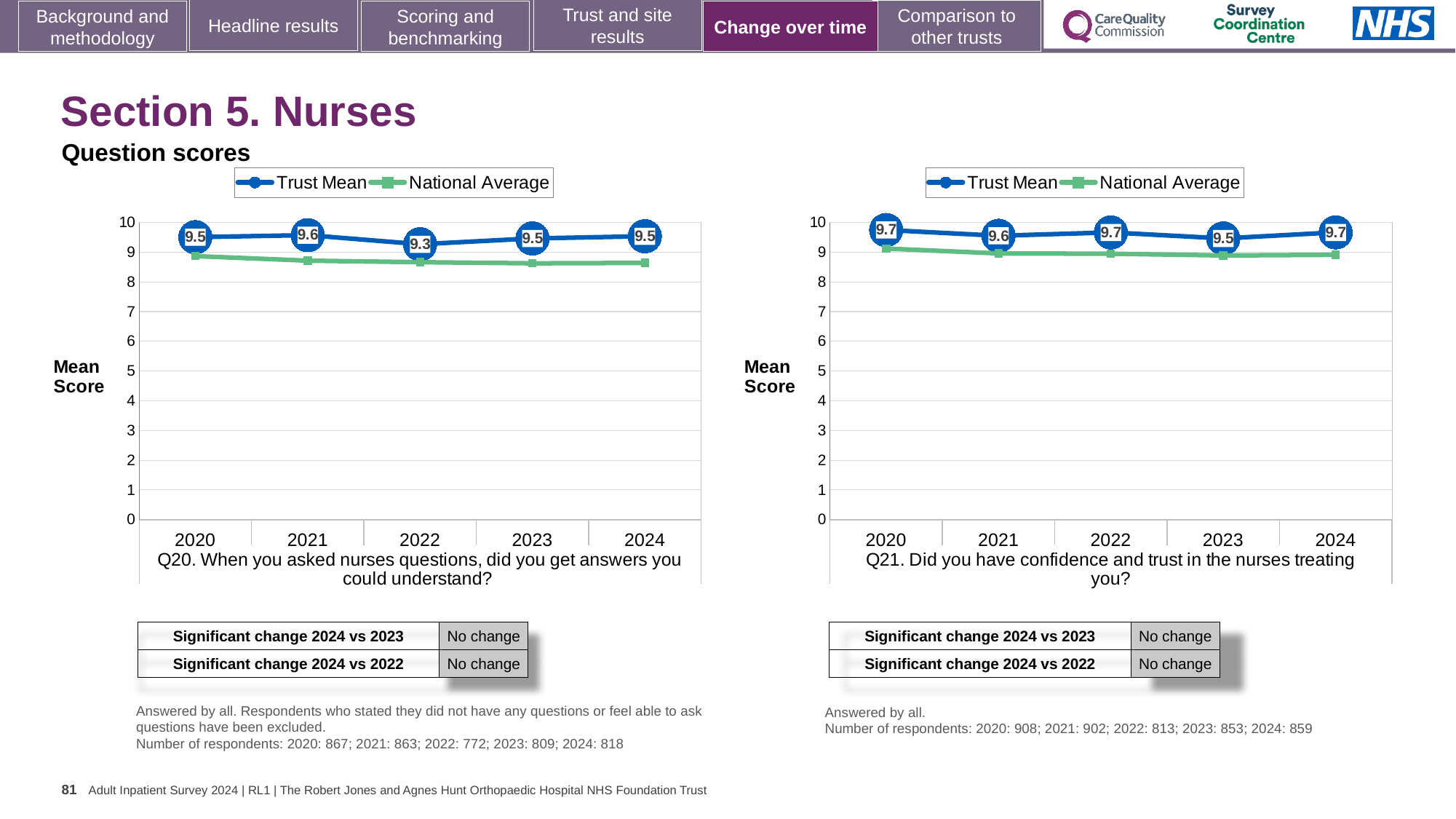
In the Q21 chart on the right, what is the Trust Mean score for 2023? 9.5 In the Q20 chart on the left, what is the Trust Mean score for 2022? 9.3 How many years are plotted on the x axis of the Q21 chart on the right? 5 What kind of chart is the Q21 chart on the right? Line chart What are the two series named in the legend of the Q20 chart on the left? Trust Mean and National Average In the Q21 chart on the right, which year has the lowest Trust Mean score? 2023 How many series does the legend of the Q20 chart on the left list? 2 In the Q20 chart on the left, what is the difference between the Trust Mean scores for 2021 and 2022? 0.3 In the Q20 chart on the left, which year has the highest Trust Mean score? 2021 In the Q21 chart on the right, which is higher in 2020: the Trust Mean or the National Average? Trust Mean In the Q20 chart on the left, is the National Average value for 2024 greater or less than 9? less In the Q20 chart on the left, which year has the lowest Trust Mean score? 2022